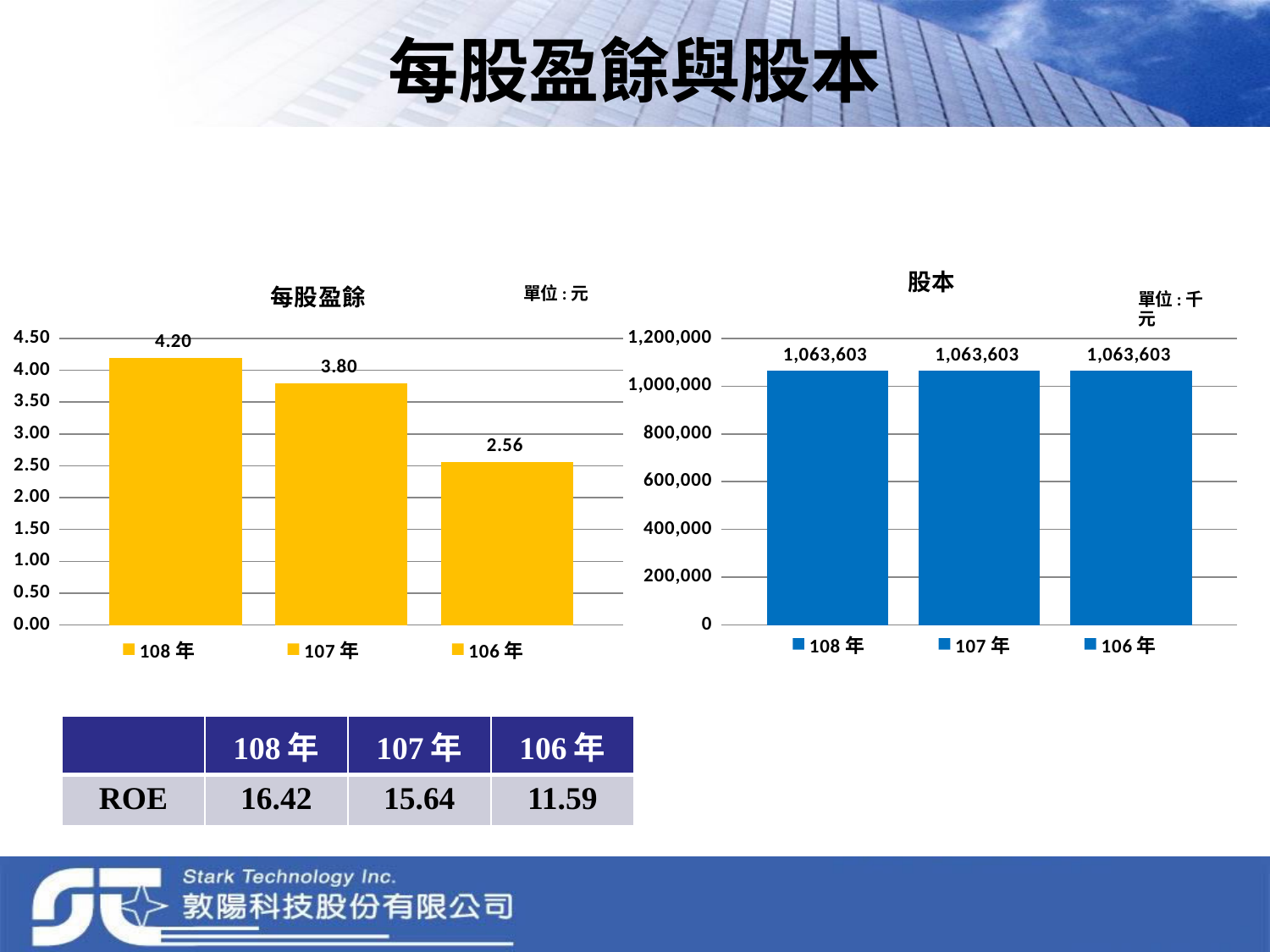
In the 每股盈餘 chart, which year has the lowest value? 106 年 In the 股本 chart, how many entries does the legend list? 3 In the 每股盈餘 chart, what is the value for 106 年? 2.56 In the 股本 chart, how many bars are plotted? 3 What unit is shown for the 股本 chart? 千元 In the 每股盈餘 chart, what is the value for 108 年? 4.20 In the 每股盈餘 chart, what is the difference between the values for 108 年 and 107 年? 0.40 In the 每股盈餘 chart, which is larger, the value for 107 年 or 106 年? 107 年 What kind of chart is the 每股盈餘 chart? bar chart In the 每股盈餘 chart, is the value for 106 年 greater or less than 3.00? less In the 股本 chart, what is the value for 107 年? 1,063,603 In the 每股盈餘 chart, which year has the highest value? 108 年